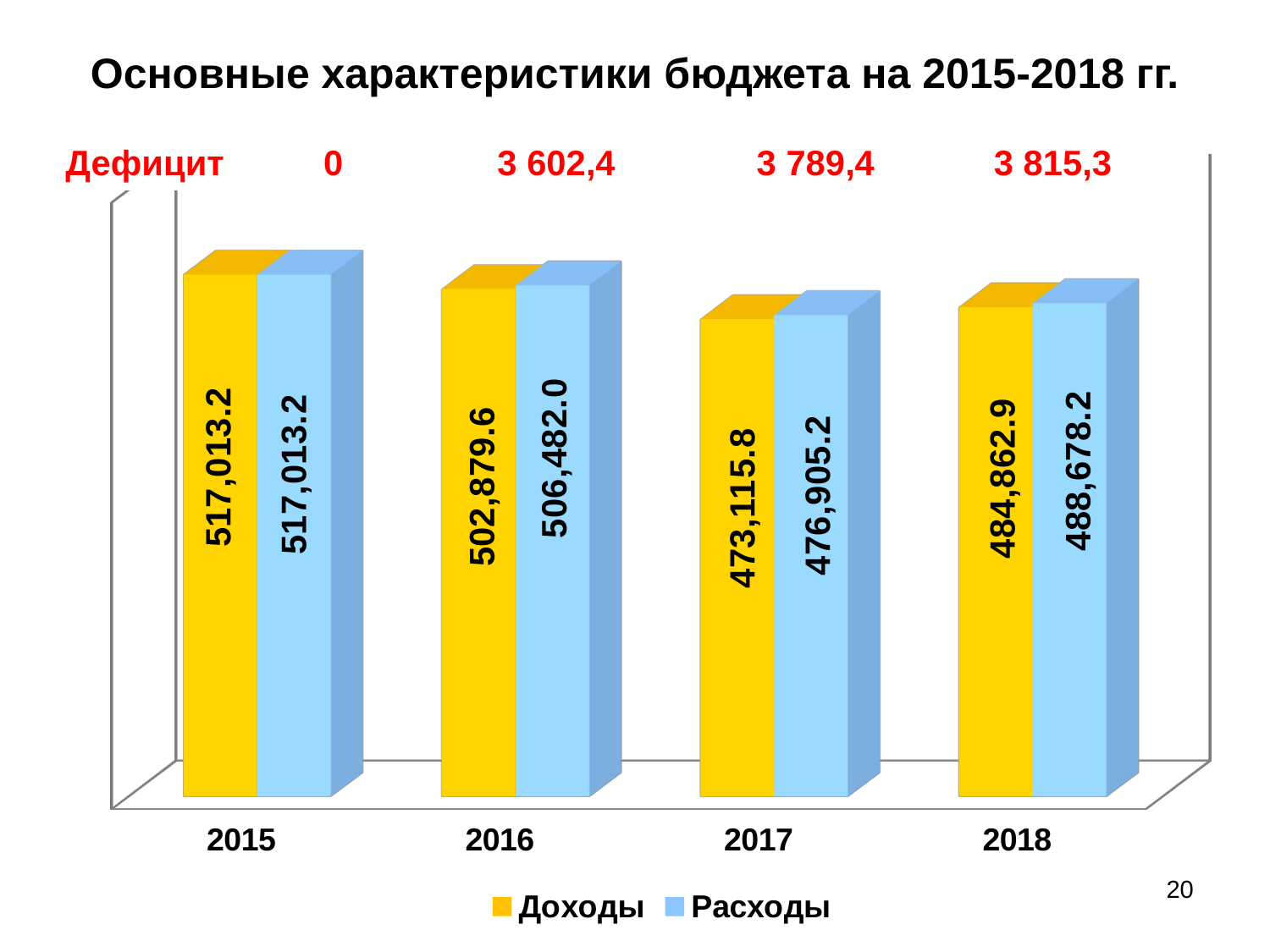
What is the difference between Доходы in 2015 and Доходы in 2018? 32,150.3 Which is larger in 2017, Доходы or Расходы? Расходы What is the value of Доходы for 2016? 502,879.6 What is the difference between Расходы and Доходы in 2016? 3,602.4 How many years are shown on the x axis? 4 What is the value of Расходы for 2017? 476,905.2 Do the Доходы values rise or fall from 2015 to 2017? Fall In which year is Расходы the lowest? 2017 What kind of chart is shown on the slide? Bar chart What is the value of Расходы for 2018? 488,678.2 In which year is Доходы the highest? 2015 How many series does the legend list? 2